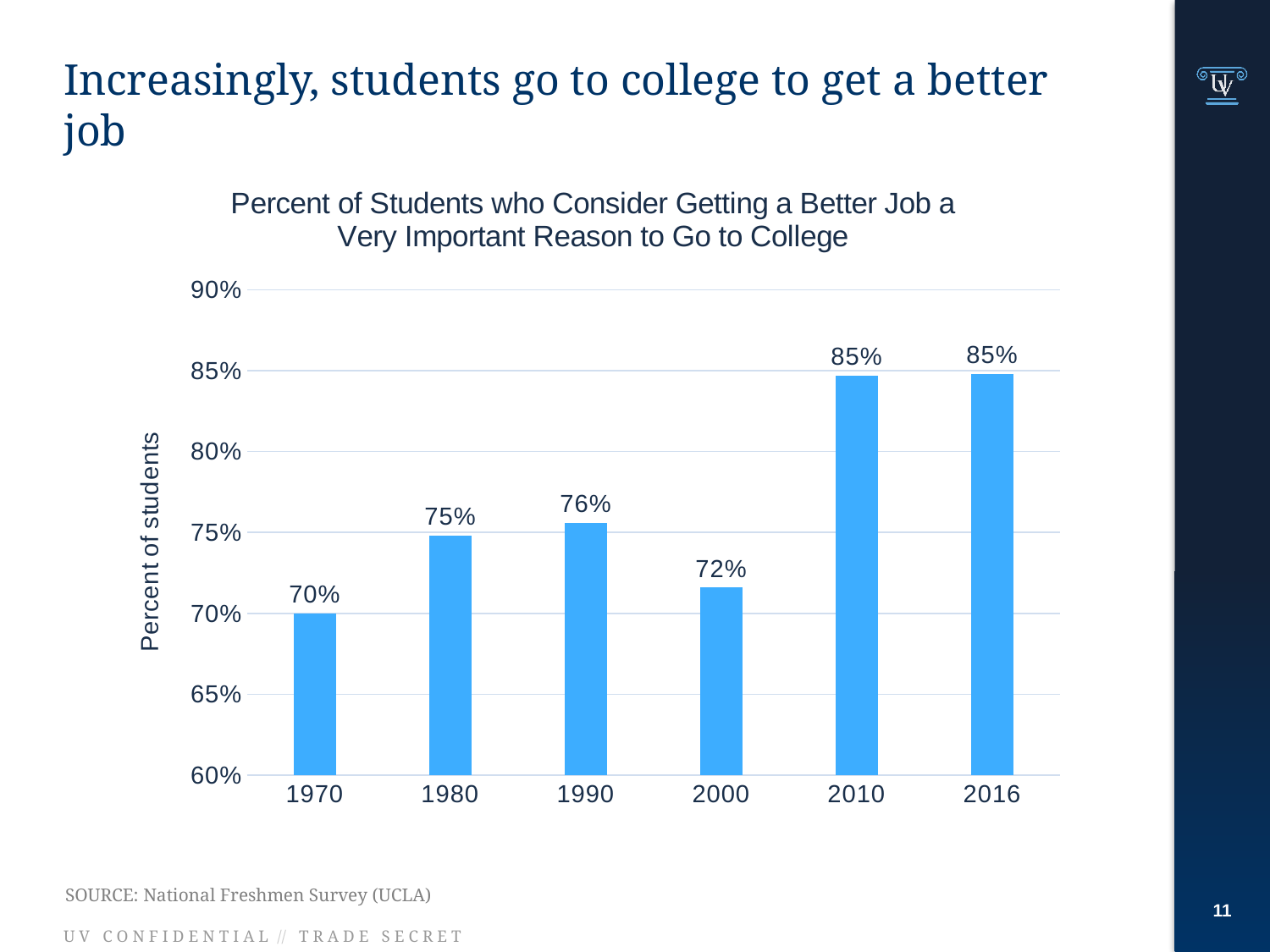
Which year has the lowest percentage of students? 1970 What is the label on the vertical axis of the chart? Percent of students What is the value shown for 1990? 76% Which years share the highest value on the chart? 2010 and 2016 What percentage of students considered getting a better job a very important reason to go to college in 1970? 70% Which year has the larger value, 1990 or 2000? 1990 How many years are shown on the x axis of the chart? 6 What kind of chart is shown on the slide? Bar chart What is the difference in percentage points between the 2010 value and the 1970 value? 15 percentage points What is the value shown for 2016? 85% Is the value for 1980 greater or less than 80%? less What is the value shown for 2000? 72%